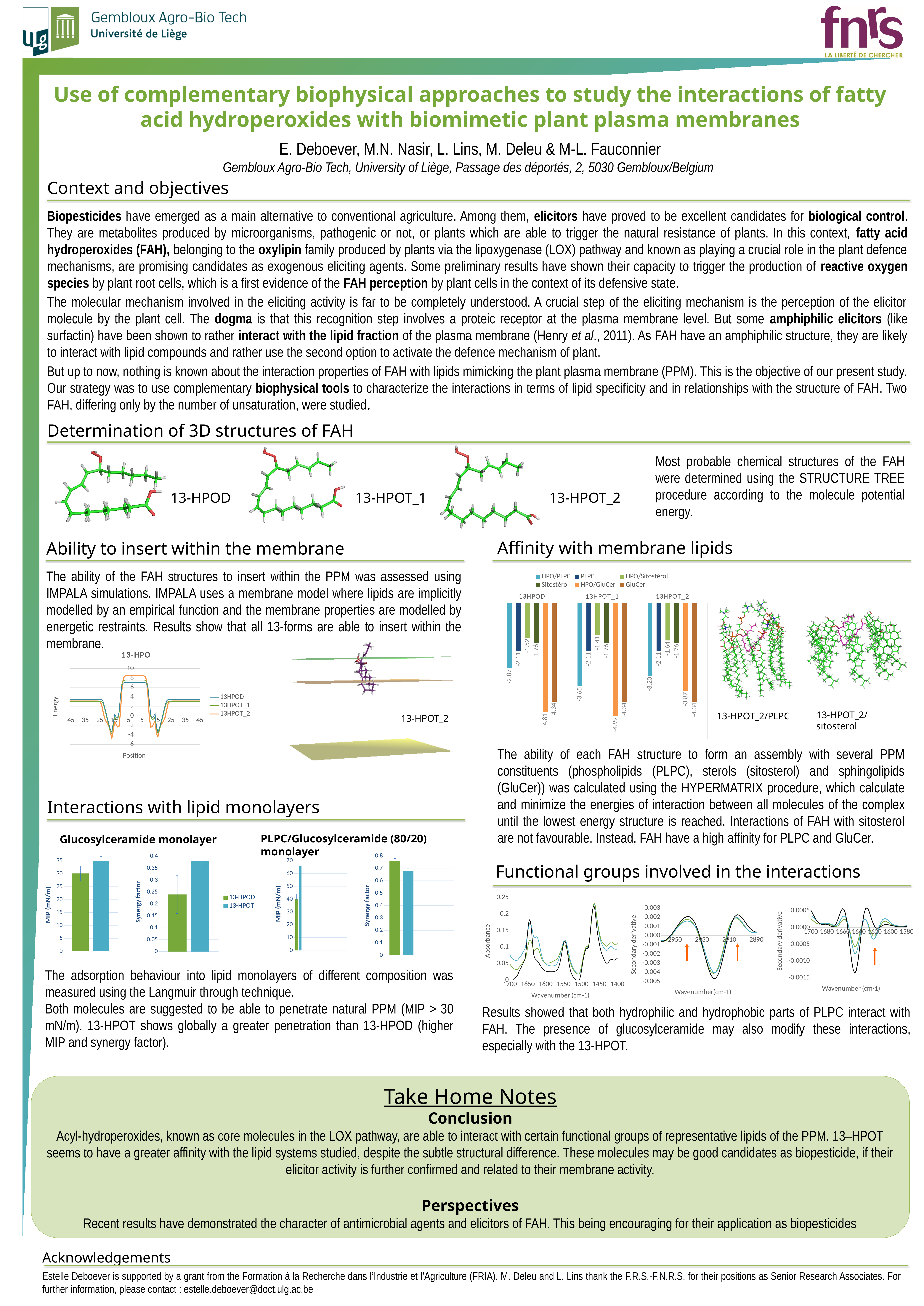
In the '13-HPO' Energy vs Position chart, how many series does the legend list? 3 In the 'Affinity with membrane lipids' bar chart, what is the difference between the HPO/GluCer values for 13HPOD and 13HPOT_2? 0.94 In the 'Affinity with membrane lipids' bar chart, how many series does the legend list? 6 In the Glucosylceramide monolayer MIP chart, which has the higher MIP, 13-HPOD or 13-HPOT? 13-HPOT In the 'Affinity with membrane lipids' bar chart, what is the value for HPO/Sitostérol in the 13HPOT_2 group? -1.64 In the Glucosylceramide monolayer Synergy factor chart, is the value for 13-HPOD greater or less than 0.3? less In the Glucosylceramide monolayer MIP chart, is the value for 13-HPOT greater or less than 30? greater In the PLPC/Glucosylceramide (80/20) monolayer MIP chart, is the value for 13-HPOD greater or less than 50? less In the 'Affinity with membrane lipids' bar chart, what is the value for HPO/GluCer in the 13HPOT_1 group? -4.99 What kind of chart is the '13-HPO' Energy vs Position chart? Line chart In the 'Affinity with membrane lipids' bar chart, what is the value for HPO/PLPC in the 13HPOD group? -2.87 In the 'Affinity with membrane lipids' bar chart, which series has the most negative value in the 13HPOT_1 group? HPO/GluCer